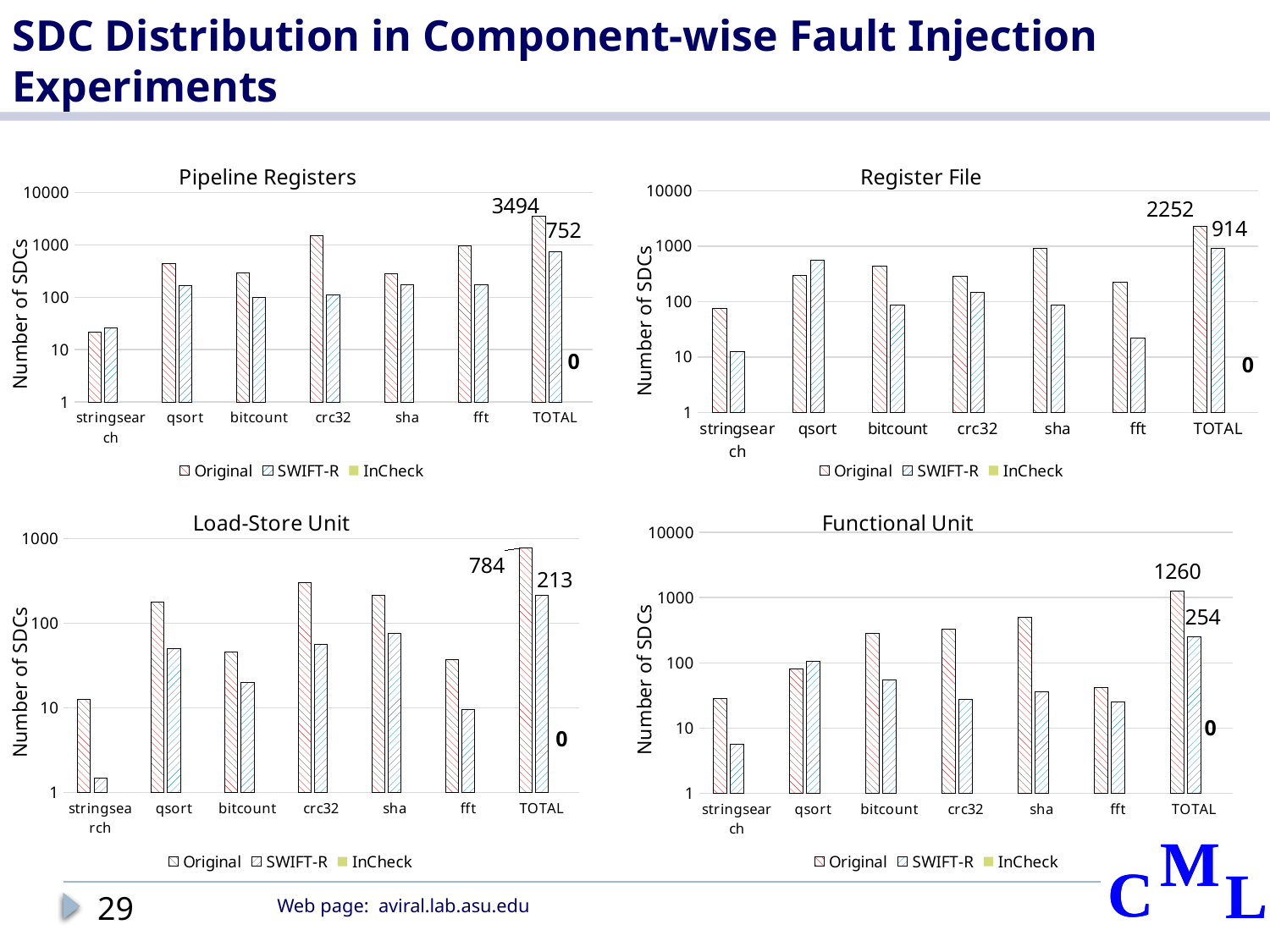
In the Pipeline Registers chart, what is the value of the Original series for TOTAL? 3494 In the Pipeline Registers chart, what is the difference between the Original and SWIFT-R values for TOTAL? 2742 In the Pipeline Registers chart, is the Original value for crc32 greater or less than 1000? greater In the Load-Store Unit chart, what is the difference between the Original and SWIFT-R values for TOTAL? 571 Across the four charts, which chart has the highest Original TOTAL value? Pipeline Registers In the Load-Store Unit chart, is the SWIFT-R value for stringsearch greater or less than 10? less In the Load-Store Unit chart, what is the value of the InCheck series for TOTAL? 0 How many series does the legend of the Register File chart list? 3 In the Functional Unit chart, what is the value of the Original series for TOTAL? 1260 How many categories are shown on the x axis of the Functional Unit chart? 7 In the Register File chart, what is the value of the SWIFT-R series for TOTAL? 914 In the Register File chart, which is larger for TOTAL: Original or SWIFT-R? Original